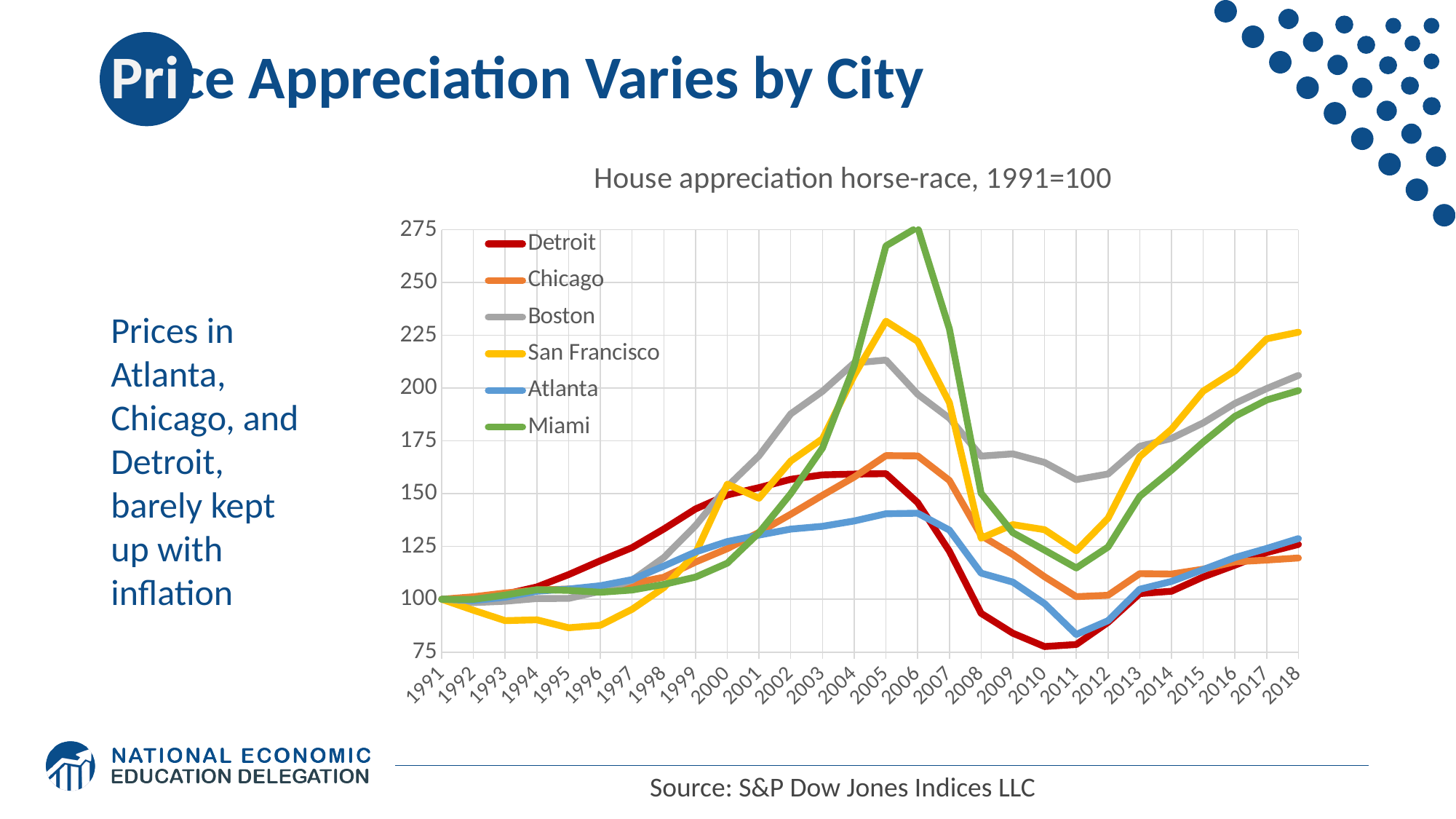
Is the value for Miami in 2006 greater or less than 250? greater What is the index value for Detroit in 1991? 100 How many series does the legend list? 6 Which city has the highest value in 2018? San Francisco Is the value for Detroit in 2010 greater or less than 100? less Does the Detroit line rise or fall between 2006 and 2010? fall Which city has the highest value in 2006? Miami What kind of chart is shown on the slide? line chart In 2018, which is larger, the value for Boston or the value for Atlanta? Boston Is the value for Boston in 2005 greater or less than 200? greater Which city has the lowest value in 2010? Detroit How many years are plotted along the x axis? 28